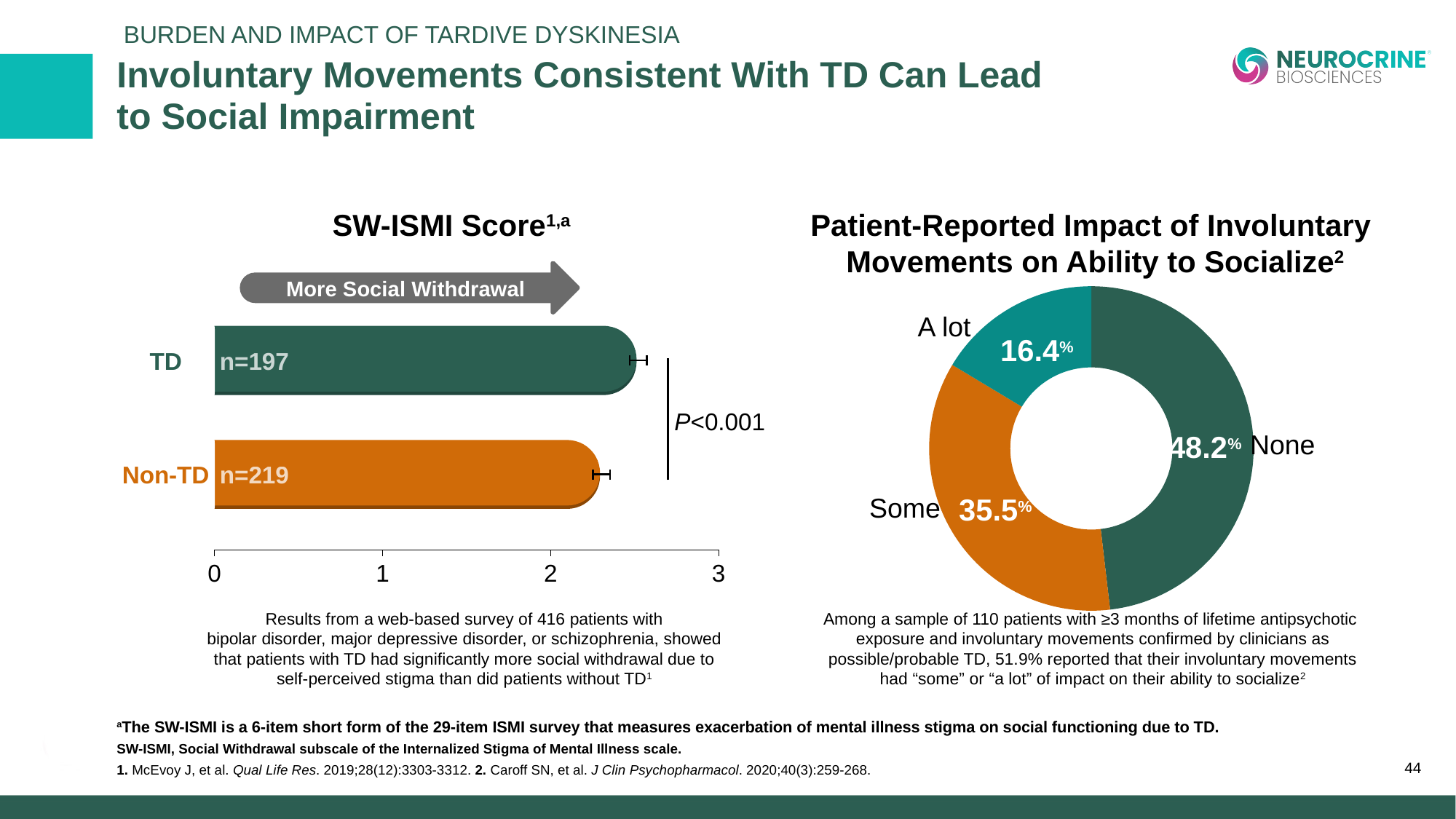
In the SW-ISMI Score chart, what is the sample size shown for the TD group? n=197 In the SW-ISMI Score chart, is the value for Non-TD greater or less than 3? less In the SW-ISMI Score chart, is the value for TD greater or less than 2? greater In the SW-ISMI Score chart, what P value is shown for the comparison between TD and Non-TD? P<0.001 In the Patient-Reported Impact of Involuntary Movements on Ability to Socialize chart, what share of patients reported 'A lot'? 16.4% In the SW-ISMI Score chart, what is the sample size shown for the Non-TD group? n=219 In the Patient-Reported Impact of Involuntary Movements on Ability to Socialize chart, what is the difference in percentage points between 'None' and 'Some'? 12.7 In the Patient-Reported Impact of Involuntary Movements on Ability to Socialize chart, what share of patients reported 'None'? 48.2% In the SW-ISMI Score chart, what kind of chart is shown? bar chart In the SW-ISMI Score chart, how many groups are plotted? 2 In the Patient-Reported Impact of Involuntary Movements on Ability to Socialize chart, which response category has the smallest share? A lot In the SW-ISMI Score chart, which group has the higher score, TD or Non-TD? TD